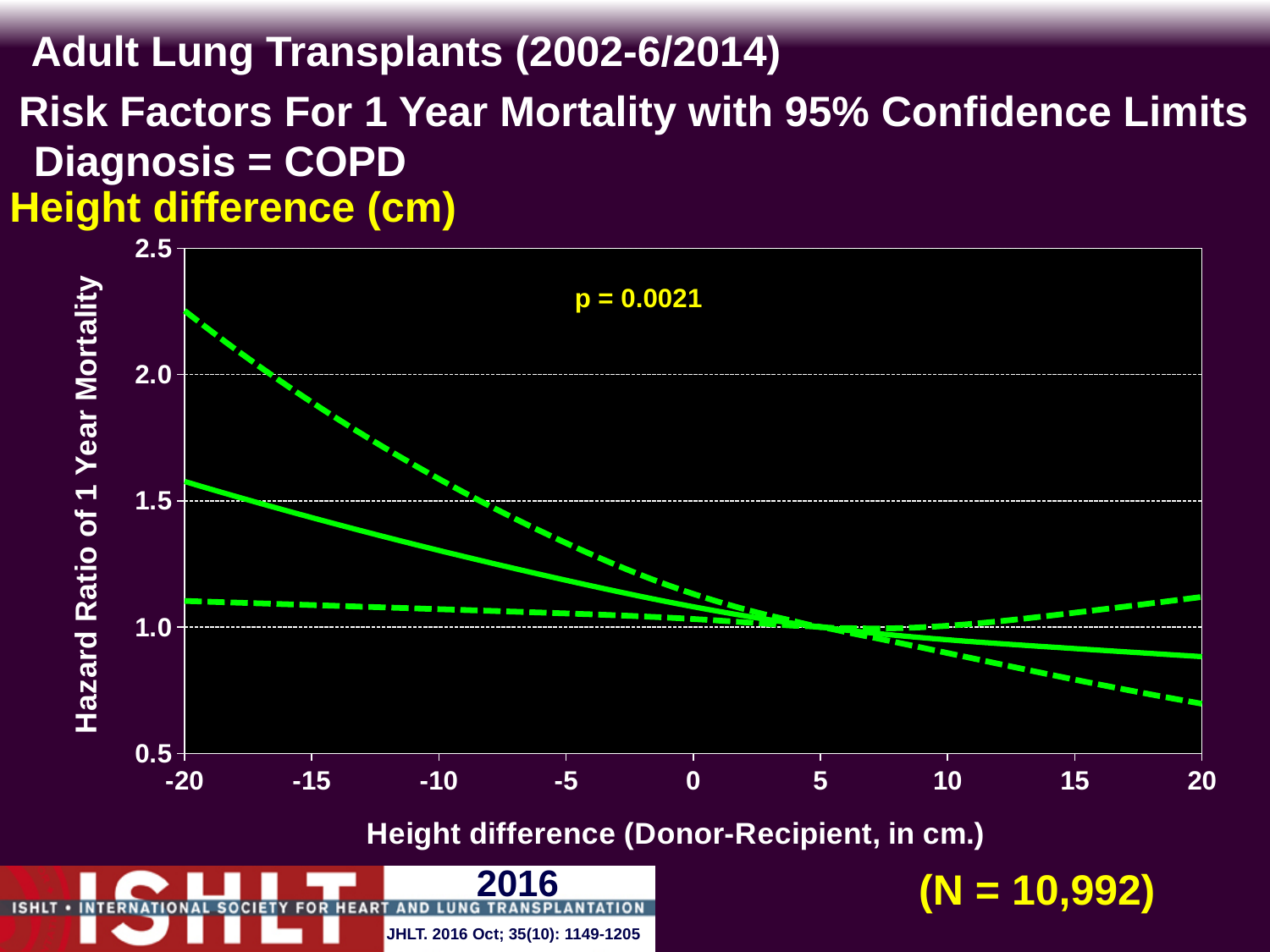
How many lines are plotted on the chart? 3 Does the solid hazard ratio line rise or fall as the height difference increases from -20 to 20? fall Is the solid hazard ratio line at a height difference of 20 greater or less than 1.0? less Is the solid hazard ratio line at a height difference of -10 greater or less than 1.5? less What kind of chart is shown on the slide? line chart Is the lower dashed confidence limit at a height difference of 20 greater or less than 1.0? less What p-value is printed on the chart? p = 0.0021 What is the title of the y axis? Hazard Ratio of 1 Year Mortality Which is larger at a height difference of -20: the solid hazard ratio line or the upper dashed confidence limit? the upper dashed confidence limit